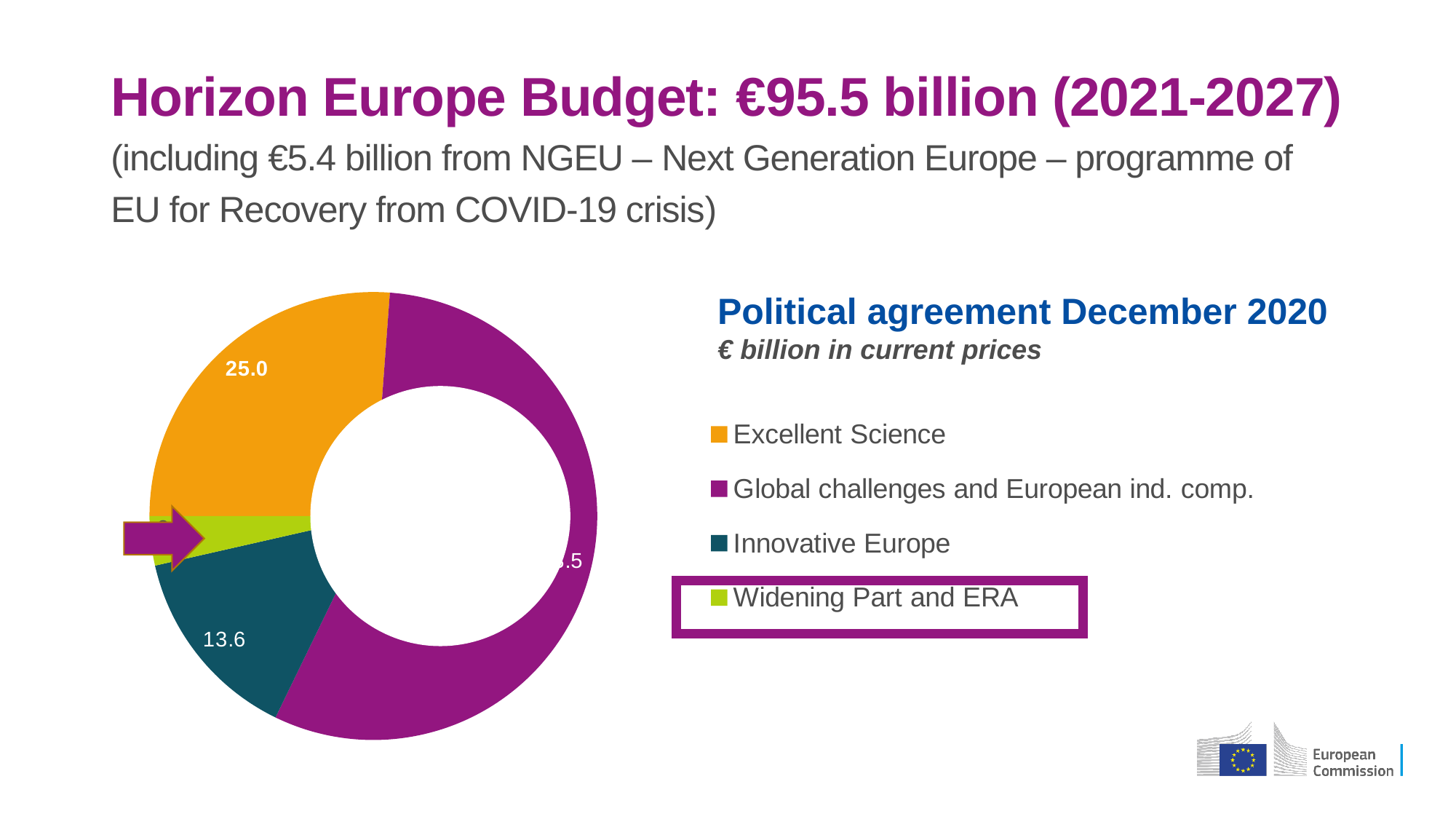
Which is larger, the slice for Excellent Science or the slice for Innovative Europe? Excellent Science What is the difference between the values for Excellent Science and Innovative Europe? 11.4 What kind of chart is shown on the slide? Doughnut (pie) chart What is the value shown for Innovative Europe in the doughnut chart? 13.6 What is the value shown for Excellent Science in the doughnut chart? 25.0 Which category has the largest slice in the doughnut chart? Global challenges and European ind. comp. Which is larger, the slice for Global challenges and European ind. comp. or the slice for Excellent Science? Global challenges and European ind. comp. Which legend entry is highlighted with a box and pointed to by an arrow? Widening Part and ERA What unit is stated for the values in the chart? € billion in current prices How many categories does the doughnut chart show? 4 Which category has the smallest slice in the doughnut chart? Widening Part and ERA